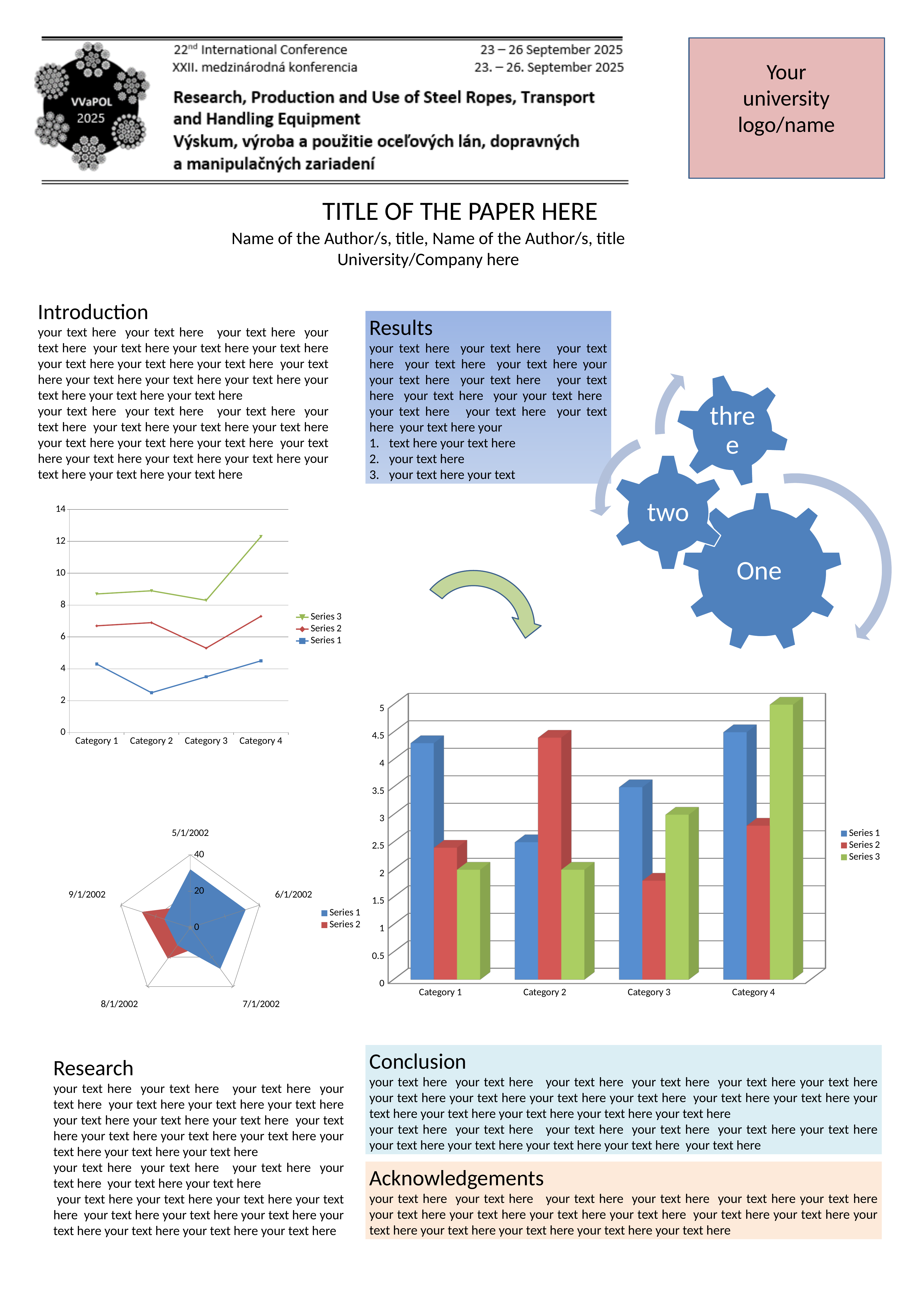
In the line chart at the top left, how many series does the legend list? 3 In the radar chart at the bottom left, how many categories are plotted around the chart? 5 In the line chart at the top left, which category has the highest value for Series 3? Category 4 What kind of chart is the chart on the right side of the slide? bar chart In the bar chart on the right, which category has the highest value for Series 3? Category 4 What kind of chart is the chart at the bottom left of the slide? radar chart In the radar chart at the bottom left, how many series does the legend list? 2 In the line chart at the top left, which category has the lowest value for Series 1? Category 2 In the bar chart on the right, which is larger at Category 2: Series 1 or Series 2? Series 2 What kind of chart is the chart at the top left of the slide? line chart In the bar chart on the right, is the value of Series 2 at Category 3 greater or less than 2? less